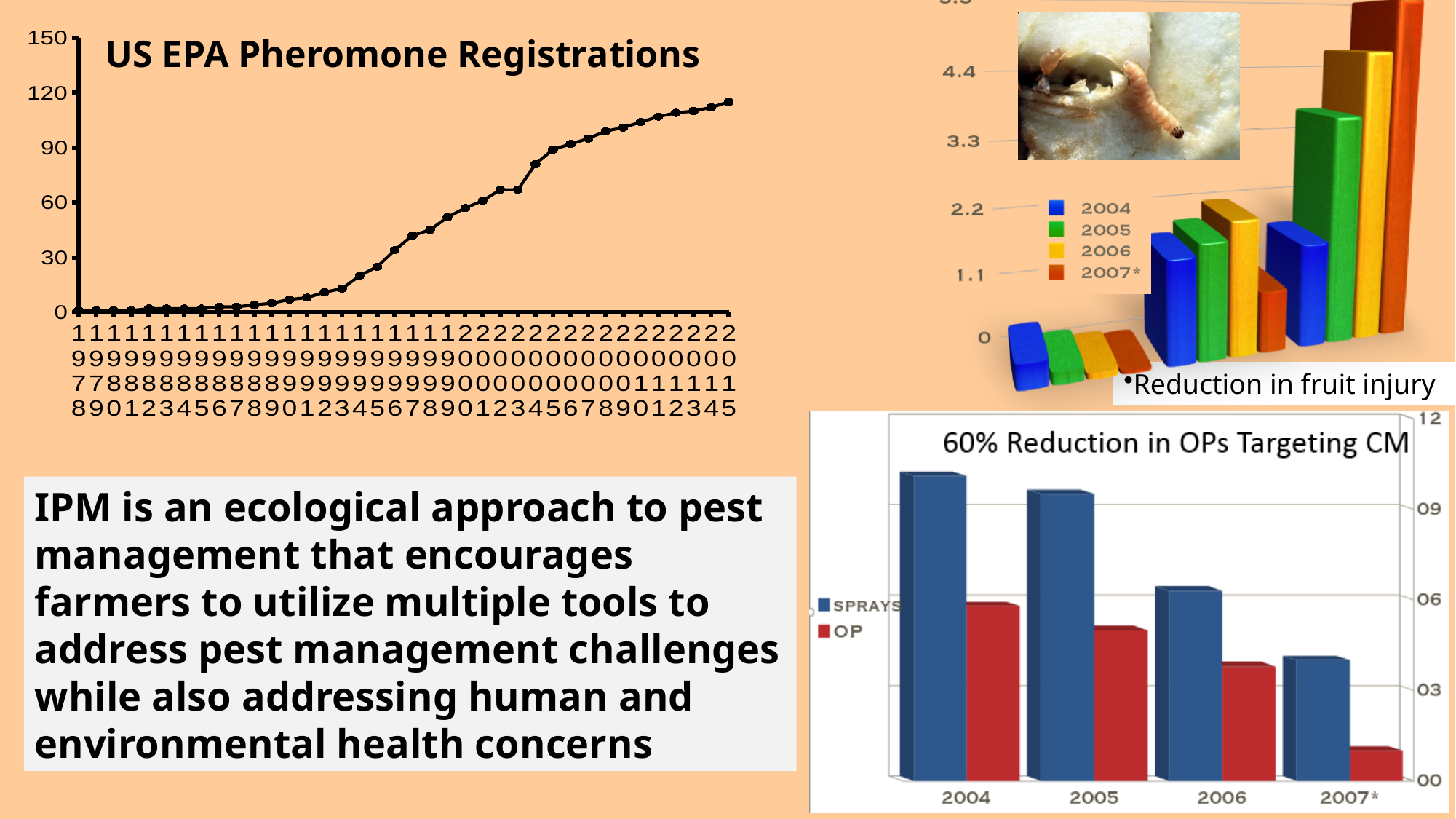
In the '60% Reduction in OPs Targeting CM' chart, which year has the lowest OP value? 2007* In the 'US EPA Pheromone Registrations' chart, do the values generally rise or fall from 1978 to 2015? rise What kind of chart is the 'US EPA Pheromone Registrations' chart? line chart How many year categories are shown on the x axis of the '60% Reduction in OPs Targeting CM' chart? 4 How many series does the legend of the 'Reduction in fruit injury' chart list? 4 In the 'US EPA Pheromone Registrations' chart, which year has the highest value? 2015 In the 'US EPA Pheromone Registrations' chart, is the value for 1990 greater or less than 30? less How many series does the legend of the '60% Reduction in OPs Targeting CM' chart list? 2 In the '60% Reduction in OPs Targeting CM' chart, which year has the highest SPRAYS value? 2004 What kind of chart is the '60% Reduction in OPs Targeting CM' chart? bar chart In the '60% Reduction in OPs Targeting CM' chart, is the SPRAYS value for 2004 greater or less than 9? greater In the 'US EPA Pheromone Registrations' chart, is the value for 2015 greater or less than 90? greater